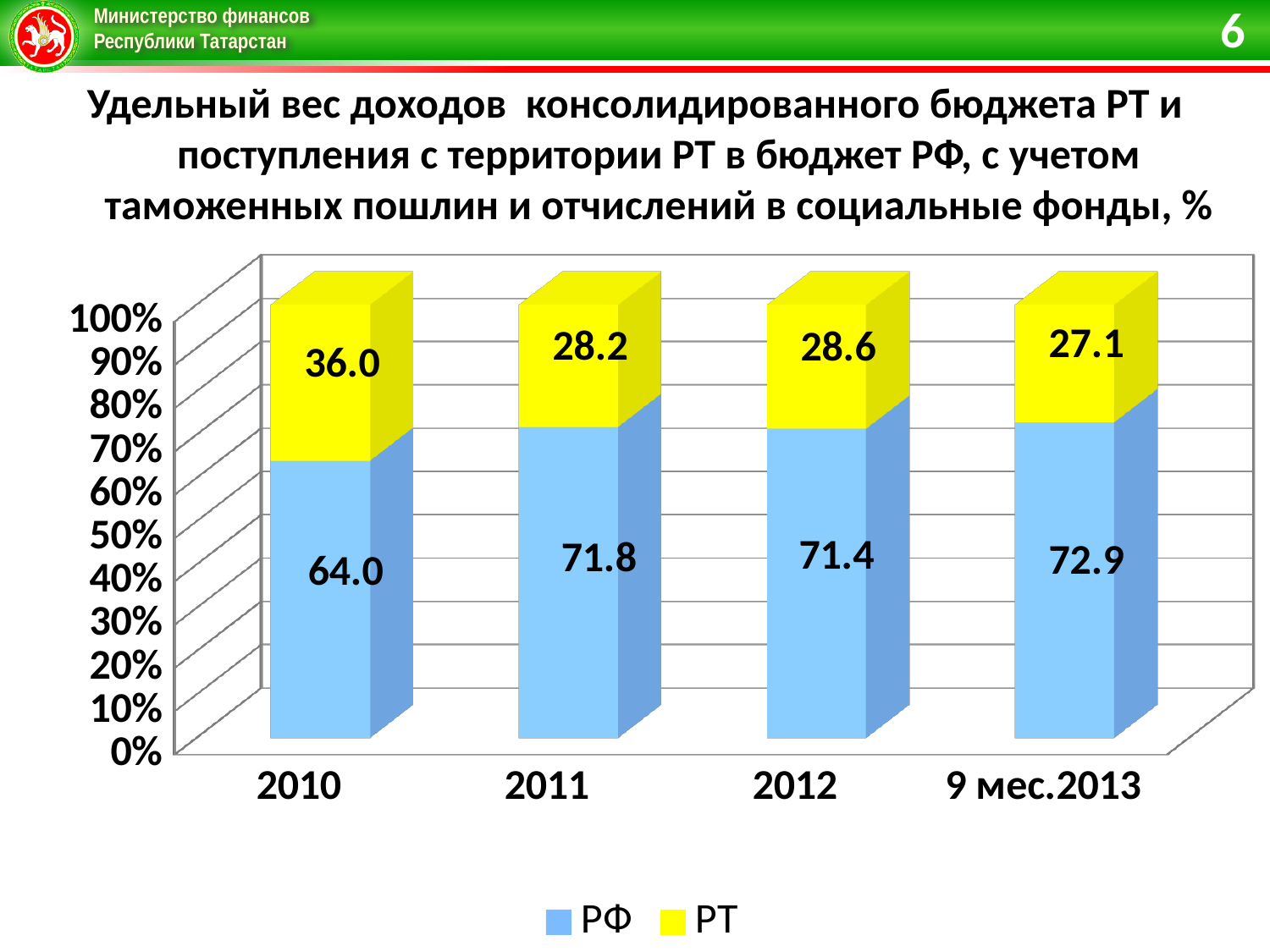
What kind of chart is shown on the slide? stacked bar chart In which category is the РТ value highest? 2010 What is the value for РТ in 2012? 28.6 What is the difference between the РФ value in 2011 and the РФ value in 2010? 7.8 What is the value for РФ in 2010? 64.0 Does the РТ value rise or fall from 2010 to 9 мес.2013? fall What is the value for РТ in 9 мес.2013? 27.1 How many series does the legend list? 2 How many categories are shown on the x axis? 4 Which series is shown in yellow? РТ In which category is the РФ value lowest? 2010 Which is larger: the РТ value in 2011 or the РТ value in 2012? 2012